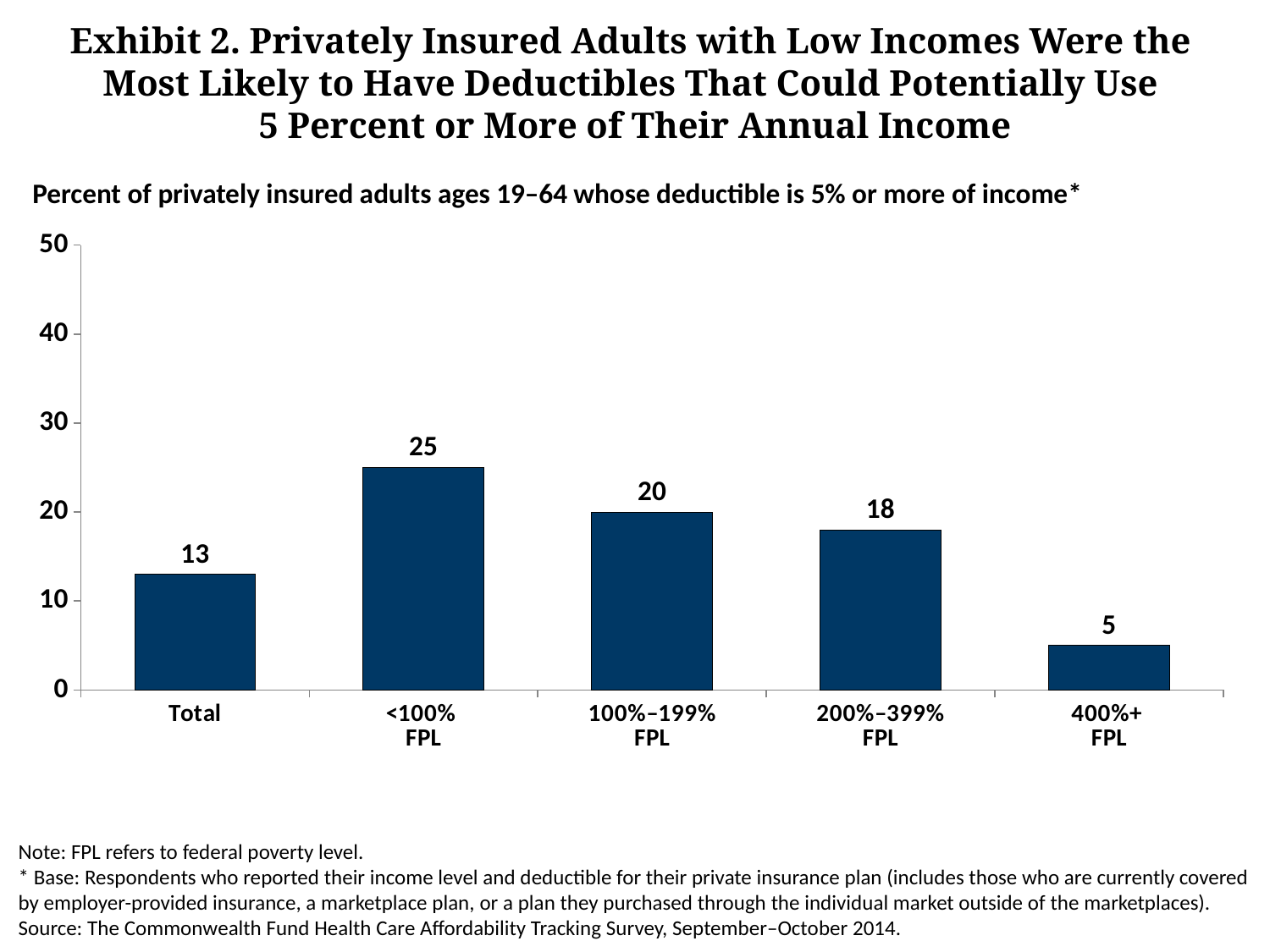
How many categories are shown on the x axis? 5 What is the value for 200%–399% FPL? 18 Do the values rise or fall across the FPL income groups from <100% FPL to 400%+ FPL? fall Which category has the highest value? <100% FPL What is the difference between the values for <100% FPL and 400%+ FPL? 20 What kind of chart is this? bar chart What is the value for Total? 13 What is the difference between the values for 100%–199% FPL and Total? 7 Which category has the lowest value? 400%+ FPL Which is larger, the value for 100%–199% FPL or the value for 200%–399% FPL? 100%–199% FPL What is the value for 400%+ FPL? 5 What is the value for <100% FPL? 25